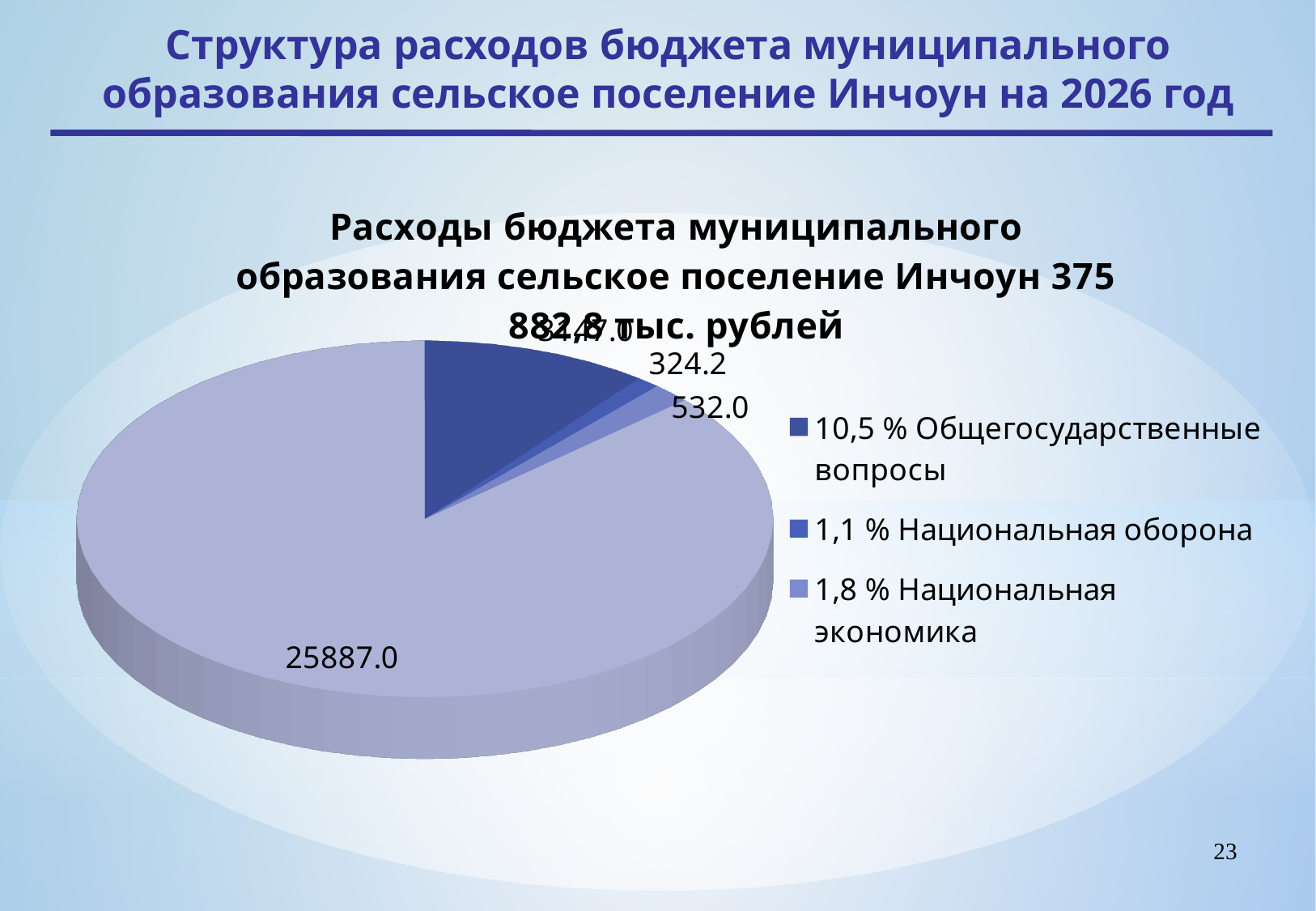
Which legend entry has the smallest percentage? Национальная оборона What value is labelled on the slice for Национальная экономика? 532.0 What is the difference between the labelled values for Национальная экономика (532.0) and Национальная оборона (324.2)? 207.8 How many entries does the chart legend list? 3 What value is labelled on the largest slice of the pie? 25887.0 What percentage does the legend give for Национальная оборона? 1,1 % What percentage does the legend give for Общегосударственные вопросы? 10,5 % What percentage does the legend give for Национальная экономика? 1,8 % What value is labelled on the slice for Национальная оборона? 324.2 What kind of chart is shown on the slide? pie chart Which slice is larger: Национальная экономика or Национальная оборона? Национальная экономика What total amount in thousand rubles is stated in the chart title? 375 882,8 тыс. рублей